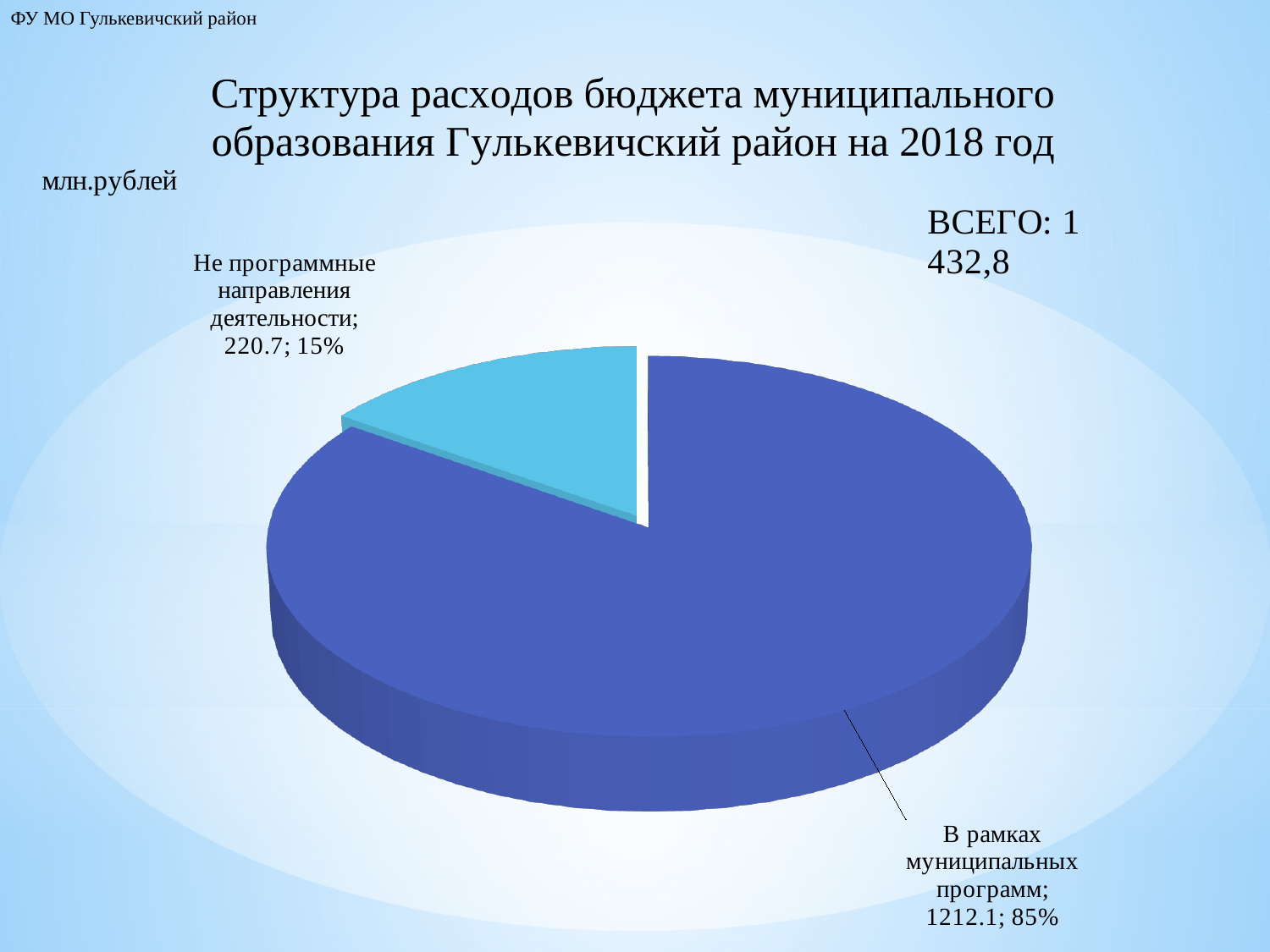
Which category has the smallest slice of the pie? Не программные направления деятельности What is the difference between the values for "В рамках муниципальных программ" and "Не программные направления деятельности"? 991.4 What share of the pie does "Не программные направления деятельности" represent? 15% What is the value for "В рамках муниципальных программ"? 1212.1 How many slices does the pie chart have? 2 Which is larger: the value for "В рамках муниципальных программ" or for "Не программные направления деятельности"? В рамках муниципальных программ What is the value for "Не программные направления деятельности"? 220.7 What total (ВСЕГО) is shown on the slide for the budget expenditures? 1 432,8 What share of the pie does "В рамках муниципальных программ" represent? 85% In what units are the values on the chart expressed? млн.рублей What kind of chart is shown on the slide? pie chart Which category has the largest slice of the pie? В рамках муниципальных программ